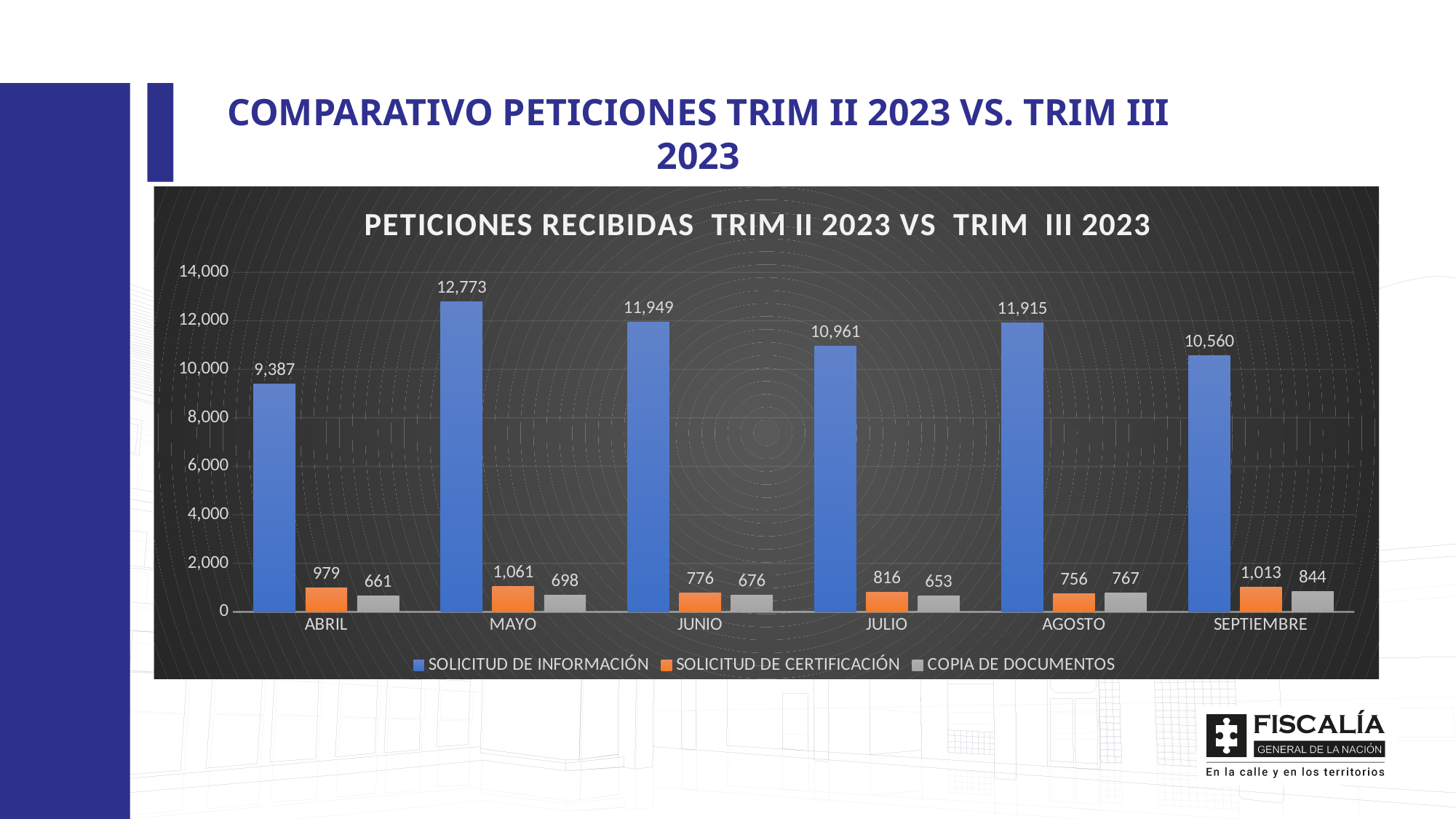
What is the value of COPIA DE DOCUMENTOS for SEPTIEMBRE? 844 Which month has the lowest value for COPIA DE DOCUMENTOS? JULIO Which month has the highest value for SOLICITUD DE INFORMACIÓN? MAYO How many series does the legend list? 3 Which is larger, SOLICITUD DE CERTIFICACIÓN for AGOSTO or COPIA DE DOCUMENTOS for AGOSTO? COPIA DE DOCUMENTOS What is the value of SOLICITUD DE CERTIFICACIÓN for JULIO? 816 Is the value of SOLICITUD DE INFORMACIÓN for JUNIO greater or less than 10,000? greater What is the value of SOLICITUD DE INFORMACIÓN for MAYO? 12,773 How many months are shown on the x axis? 6 What is the difference between the SOLICITUD DE INFORMACIÓN values for MAYO and ABRIL? 3,386 What type of chart is shown? bar chart Which month has the lowest value for SOLICITUD DE INFORMACIÓN? ABRIL